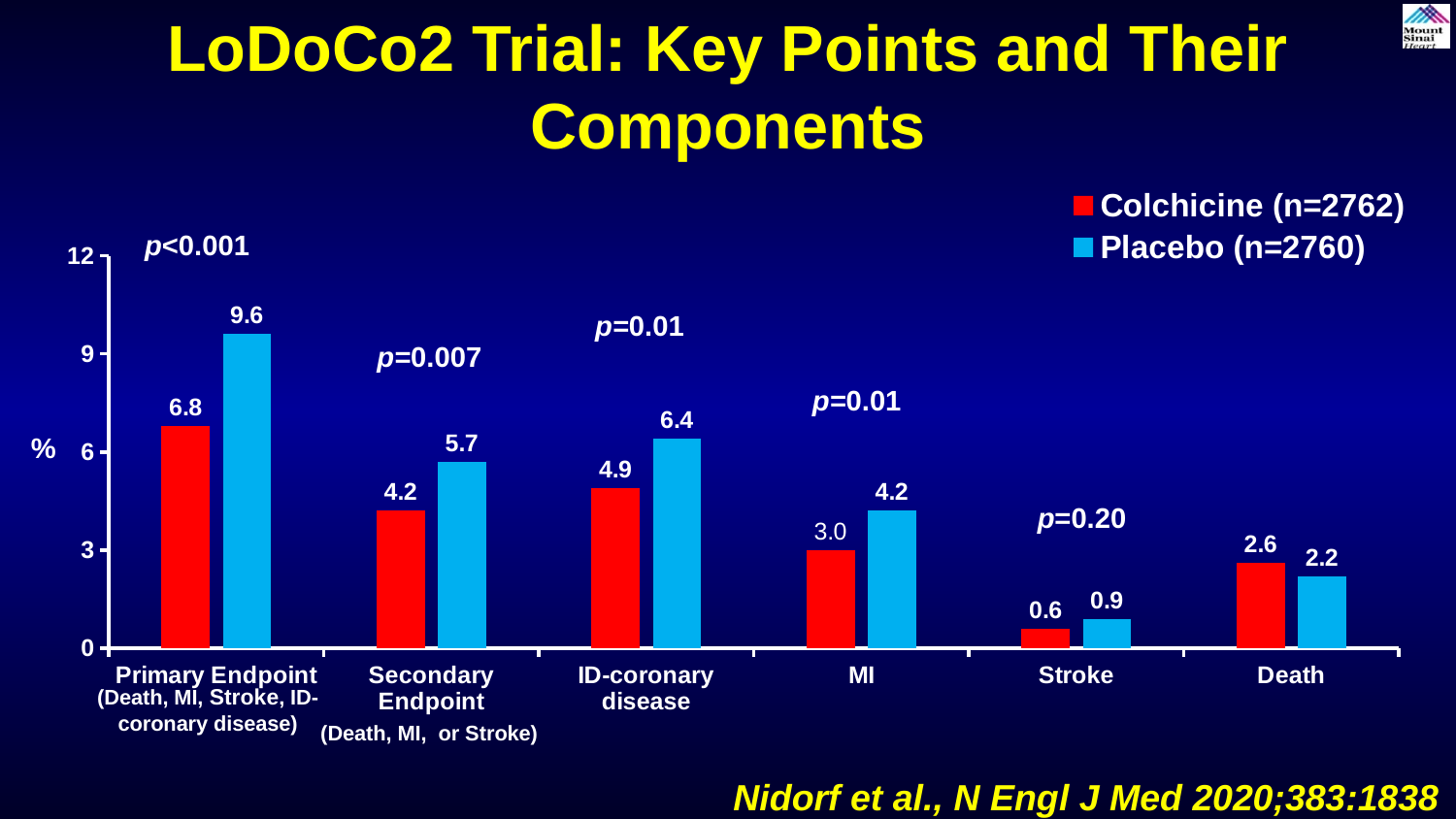
What is the Placebo value for MI? 4.2 For Death, which is larger, the Colchicine value or the Placebo value? Colchicine What p-value is shown above the Stroke bars? p=0.20 Which category has the highest Placebo value? Primary Endpoint What is the Colchicine value for the Primary Endpoint? 6.8 What is the difference between the Placebo and Colchicine values for ID-coronary disease? 1.5 What is the difference between the Placebo and Colchicine values for the Primary Endpoint? 2.8 How many categories are shown on the x axis? 6 How many series does the legend list? 2 What kind of chart is shown on the slide? Bar chart Which category has the lowest Colchicine value? Stroke What is the Placebo value for Stroke? 0.9